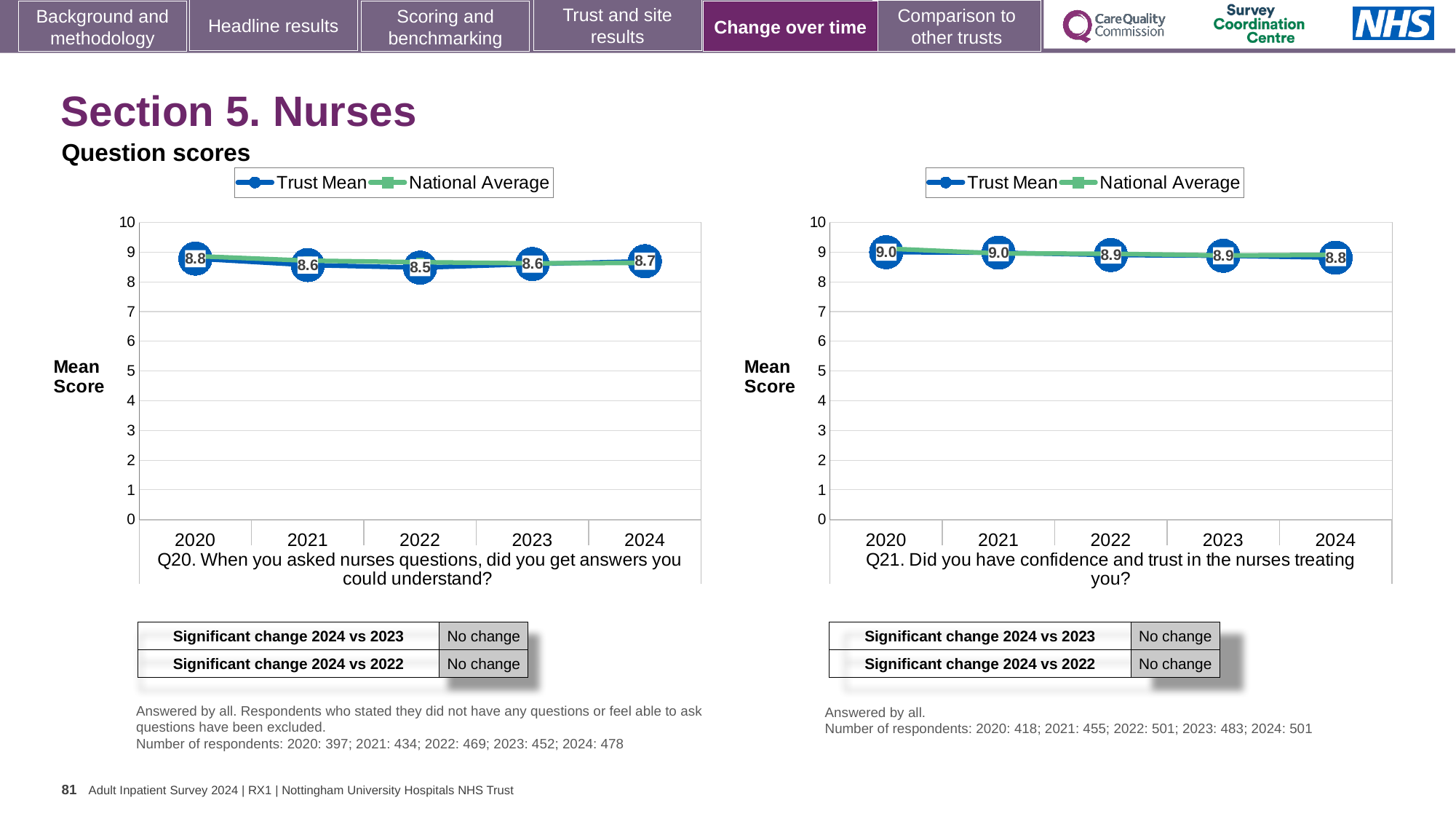
In the Q21 chart (right), which year has the lowest Trust Mean score? 2024 In the Q21 chart (right), is the Trust Mean score for 2020 higher or lower than for 2024? higher In the Q21 chart (right), what is the Trust Mean score for 2020? 9.0 How many series does the legend of the Q20 chart (left) list? 2 In the Q20 chart (left), what is the difference between the Trust Mean scores for 2020 and 2022? 0.3 In the Q20 chart (left), which year has the highest Trust Mean score? 2020 What type of chart is used for Q21 (right)? Line chart How many years are plotted on the x axis of the Q21 chart (right)? 5 In the Q20 chart (left), what is the Trust Mean score for 2024? 8.7 In the Q21 chart (right), what is the Trust Mean score for 2024? 8.8 In the Q20 chart (left), which year has the lowest Trust Mean score? 2022 In the Q20 chart (left), what is the Trust Mean score for 2022? 8.5